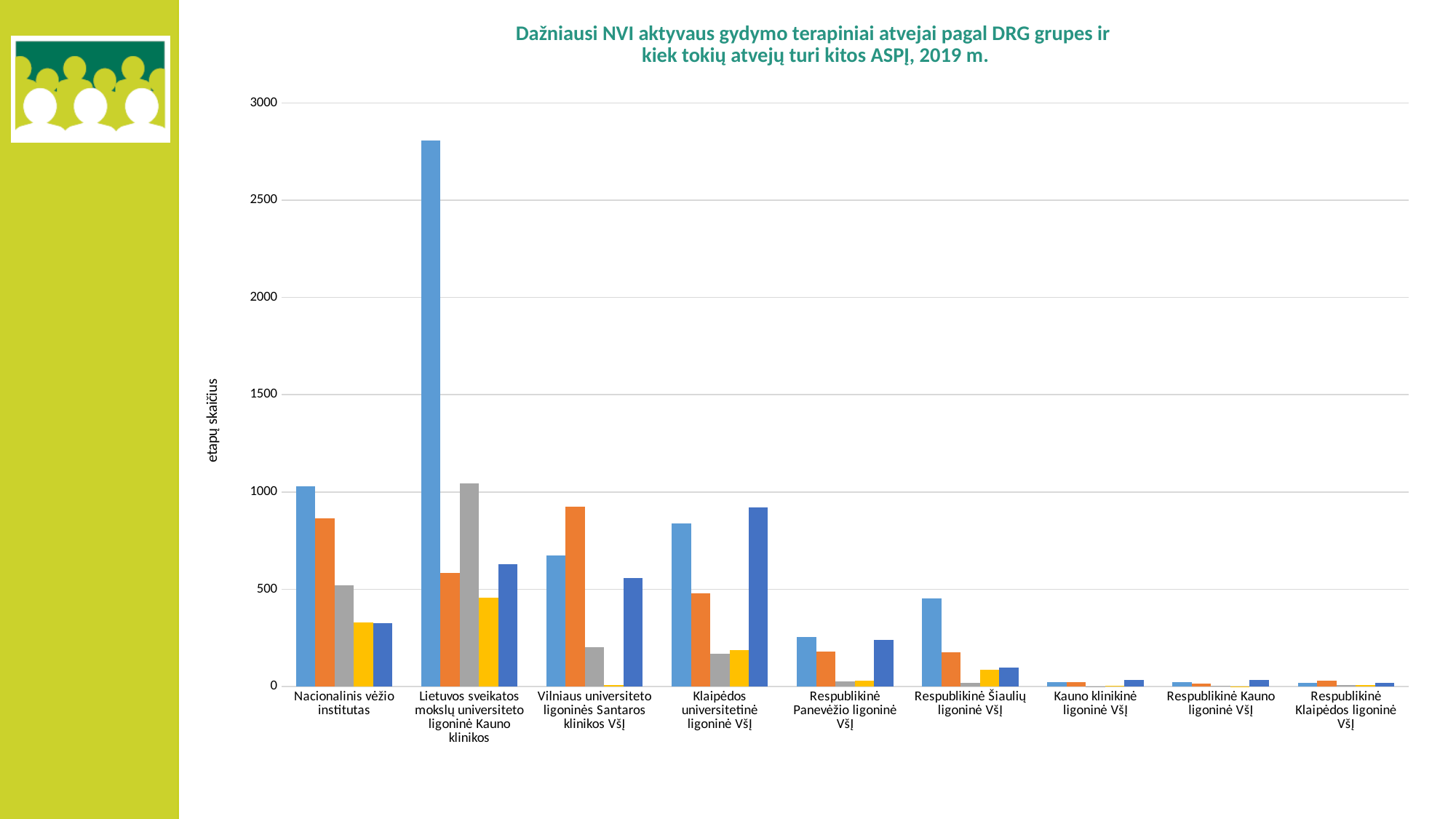
Is the light blue bar for Nacionalinis vėžio institutas greater or less than 500? greater Is the orange bar for Vilniaus universiteto ligoninės Santaros klinikos VšĮ greater or less than 1000? less Which year does the chart title say the data is for? 2019 m. Which has the larger dark blue bar: Klaipėdos universitetinė ligoninė VšĮ or Lietuvos sveikatos mokslų universiteto ligoninė Kauno klinikos? Klaipėdos universitetinė ligoninė VšĮ How many hospitals (categories) are shown along the x axis? 9 How many bars are plotted for each hospital? 5 What kind of chart is shown on the slide? bar chart Is the light blue bar for Respublikinė Panevėžio ligoninė VšĮ greater or less than 500? less Which has the larger light blue bar: Nacionalinis vėžio institutas or Klaipėdos universitetinė ligoninė VšĮ? Nacionalinis vėžio institutas What is the label of the vertical axis? etapų skaičius Which hospital has the tallest bar in the chart? Lietuvos sveikatos mokslų universiteto ligoninė Kauno klinikos